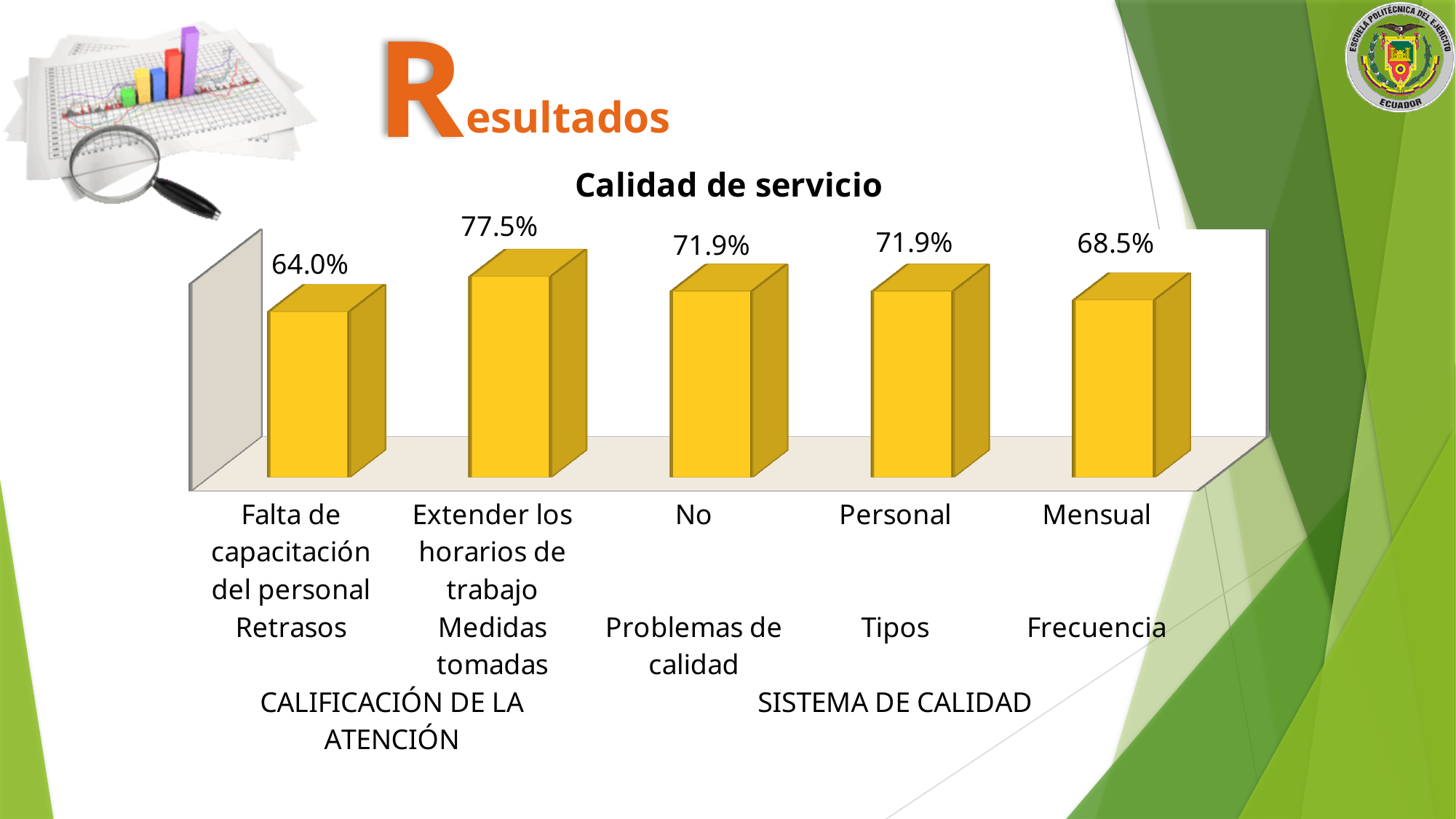
Which category has the highest value? Extender los horarios de trabajo What is the value for 'Extender los horarios de trabajo'? 77.5% Which is larger, the value for 'No' or the value for 'Mensual'? No What is the difference between the values for 'Extender los horarios de trabajo' and 'Falta de capacitación del personal'? 13.5% What is the value for 'Falta de capacitación del personal'? 64.0% How many bars are plotted in the chart? 5 What is the value for 'Personal'? 71.9% Which category has the lowest value? Falta de capacitación del personal What is the title of the chart? Calidad de servicio Which two categories share the same value of 71.9%? No and Personal What is the value for 'Mensual'? 68.5% What type of chart is shown on the slide? bar chart